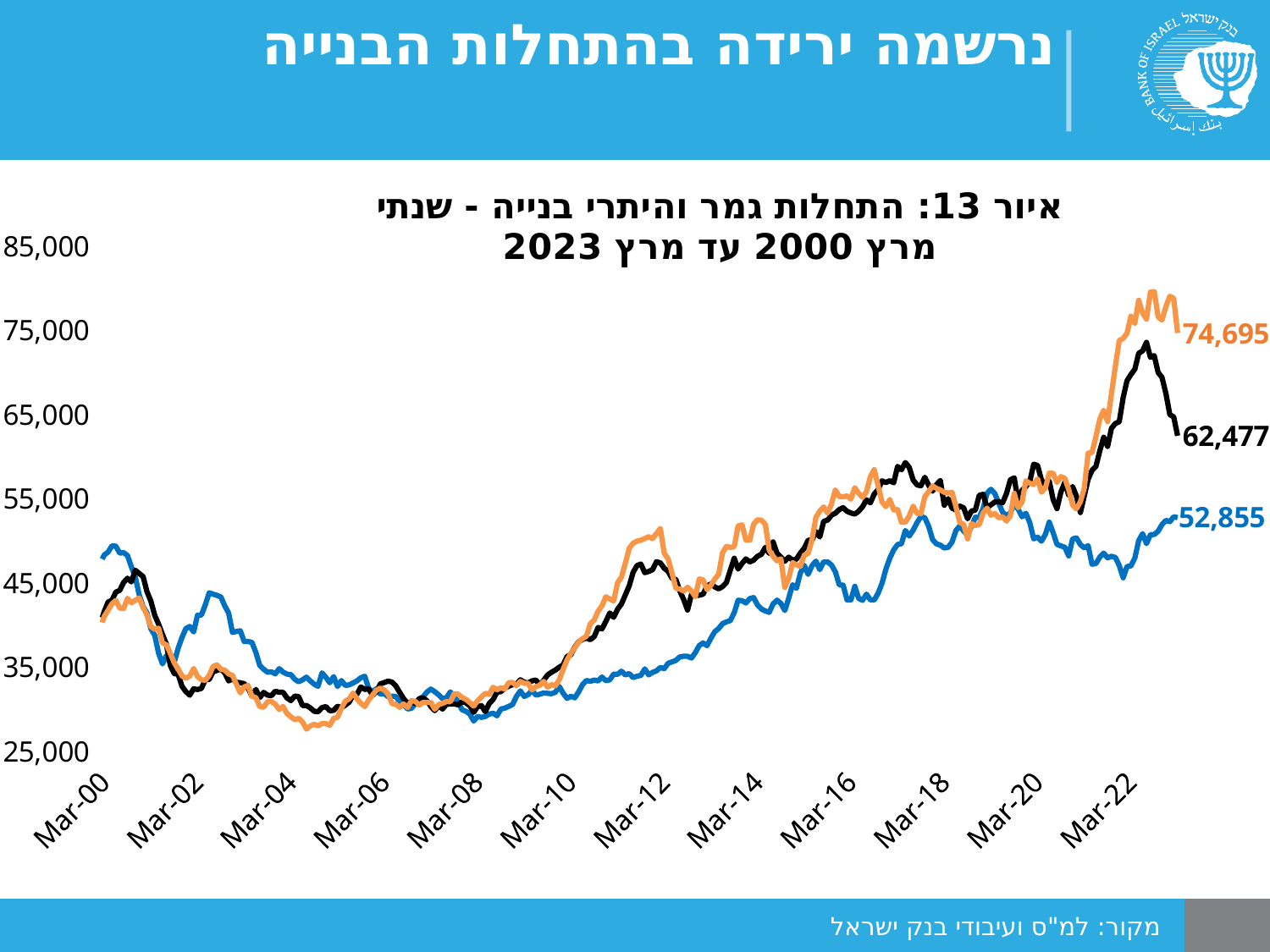
Which line ends at the highest labelled value at the right edge of the chart? the orange line Which line ends at the lowest labelled value at the right edge of the chart? the blue line What is the final labelled value of the black line? 62,477 How many lines are plotted on the chart? 3 Does the orange line rise or fall between Mar-08 and Mar-12? rise What is the final labelled value of the blue line? 52,855 What is the final labelled value of the orange line? 74,695 Is the value of the orange line at Mar-04 greater or less than 35,000? less What type of chart is shown on the slide? line chart Is the final labelled value of the orange line larger or smaller than that of the blue line? larger What is the difference between the final labelled values of the orange line and the black line? 12,218 What is the difference between the final labelled values of the black line and the blue line? 9,622